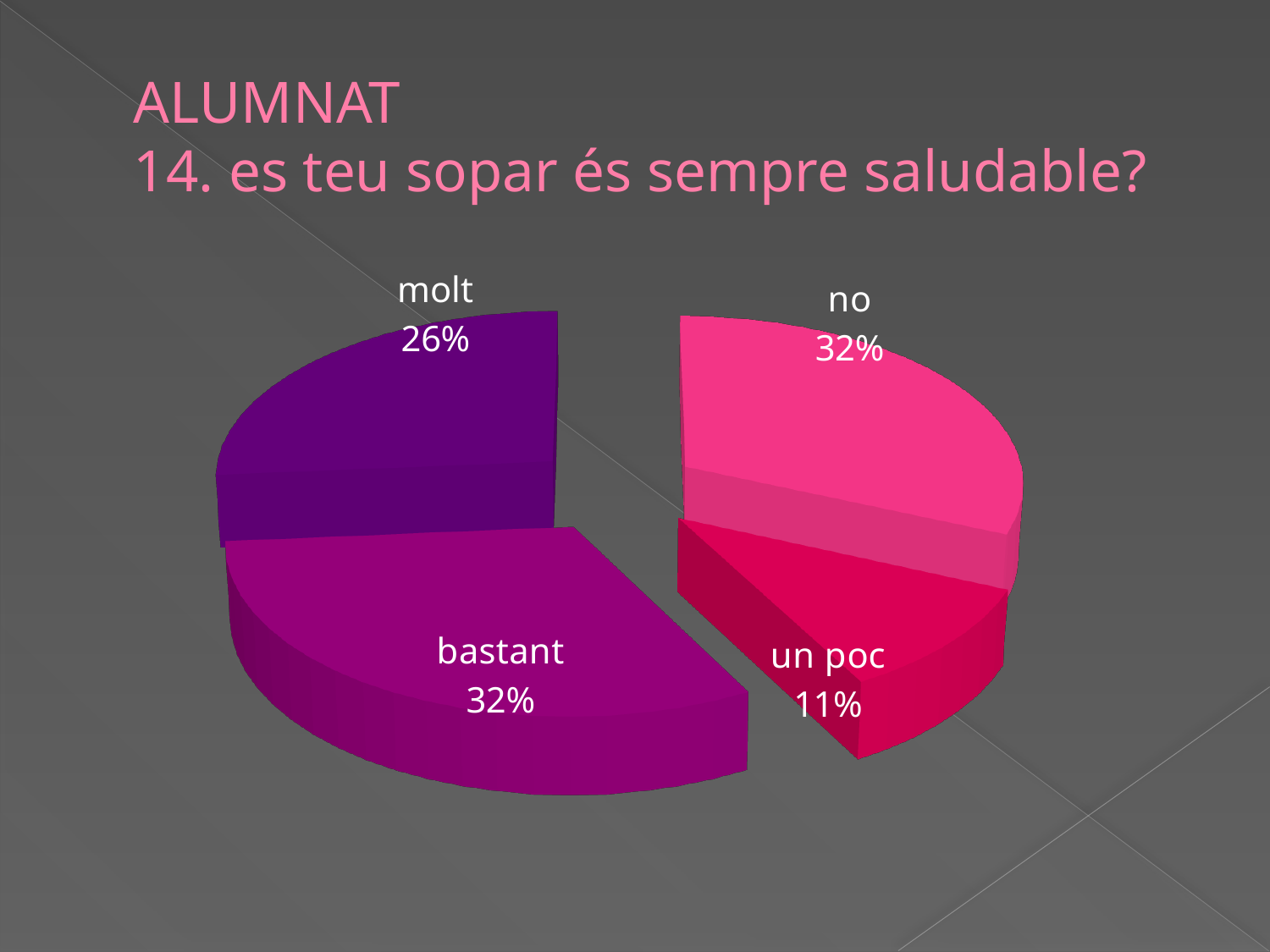
Which is larger, the "no" slice or the "molt" slice? no What share of the pie does the "un poc" slice represent? 11% Which category has the smallest slice of the pie? un poc What is the difference in percentage points between the "molt" slice and the "un poc" slice? 15 What kind of chart is shown on the slide? pie chart How many slices does the pie chart have? 4 What share of the pie does the "bastant" slice represent? 32% Which is larger, the "molt" slice or the "un poc" slice? molt What share of the pie does the "molt" slice represent? 26% What is the difference in percentage points between the "bastant" slice and the "un poc" slice? 21 What question is shown as the title of the chart slide? 14. es teu sopar és sempre saludable?